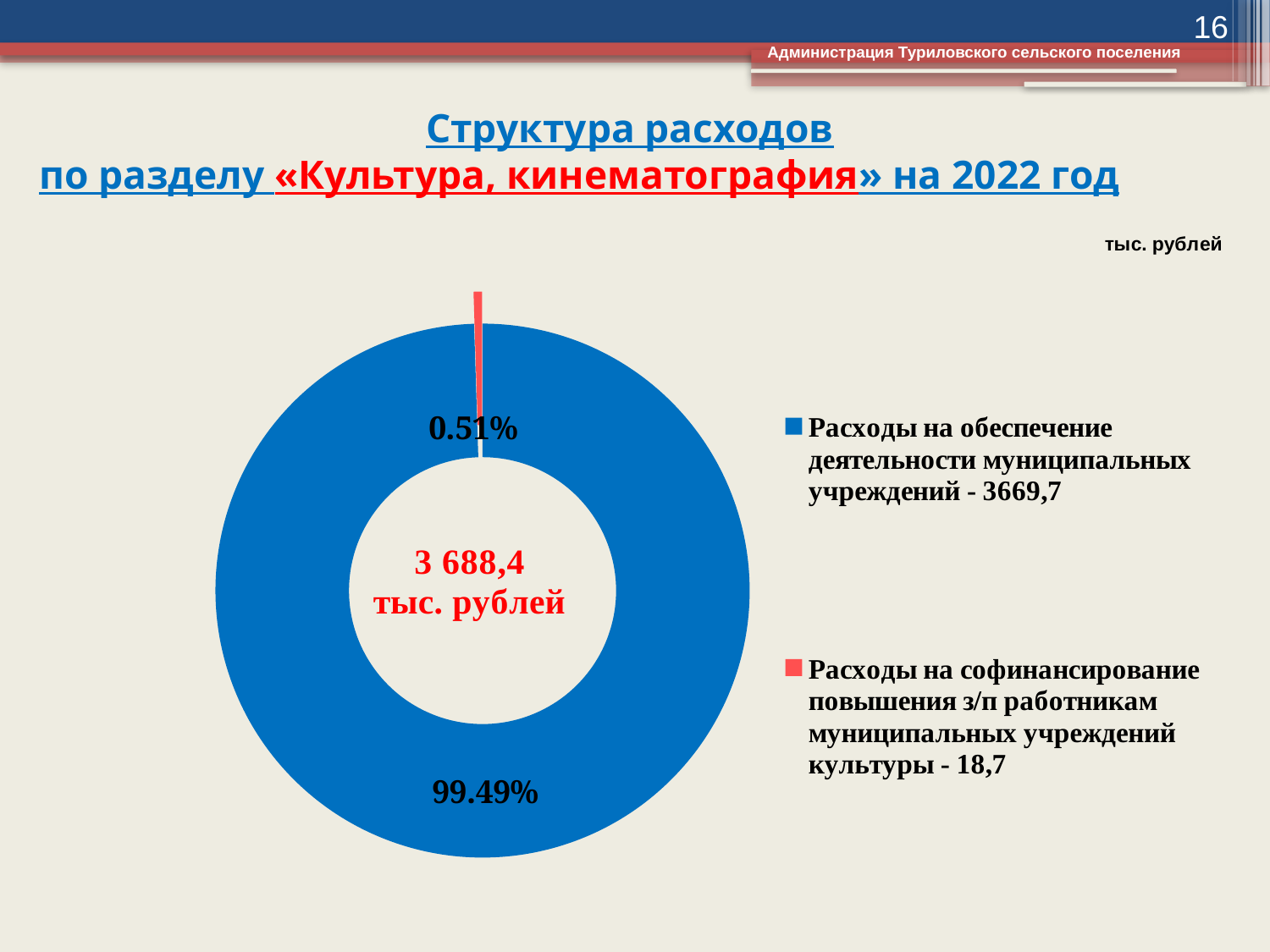
What share of the chart is labelled for "Расходы на софинансирование повышения з/п работникам муниципальных учреждений культуры"? 0.51% How many entries does the legend list? 2 Which category has the largest share of the chart? Расходы на обеспечение деятельности муниципальных учреждений How many categories does the chart show? 2 Which category has the smallest share of the chart? Расходы на софинансирование повышения з/п работникам муниципальных учреждений культуры What total amount is shown in the centre of the chart? 3 688,4 тыс. рублей What value (тыс. рублей) does the legend give for "Расходы на софинансирование повышения з/п работникам муниципальных учреждений культуры"? 18,7 What share of the chart is labelled for "Расходы на обеспечение деятельности муниципальных учреждений"? 99.49% What kind of chart is shown on the slide? Doughnut (pie) chart What is the difference in percentage points between the two slices of the chart? 98.98 percentage points Which colour represents "Расходы на софинансирование повышения з/п работникам муниципальных учреждений культуры"? Red What value (тыс. рублей) does the legend give for "Расходы на обеспечение деятельности муниципальных учреждений"? 3669,7